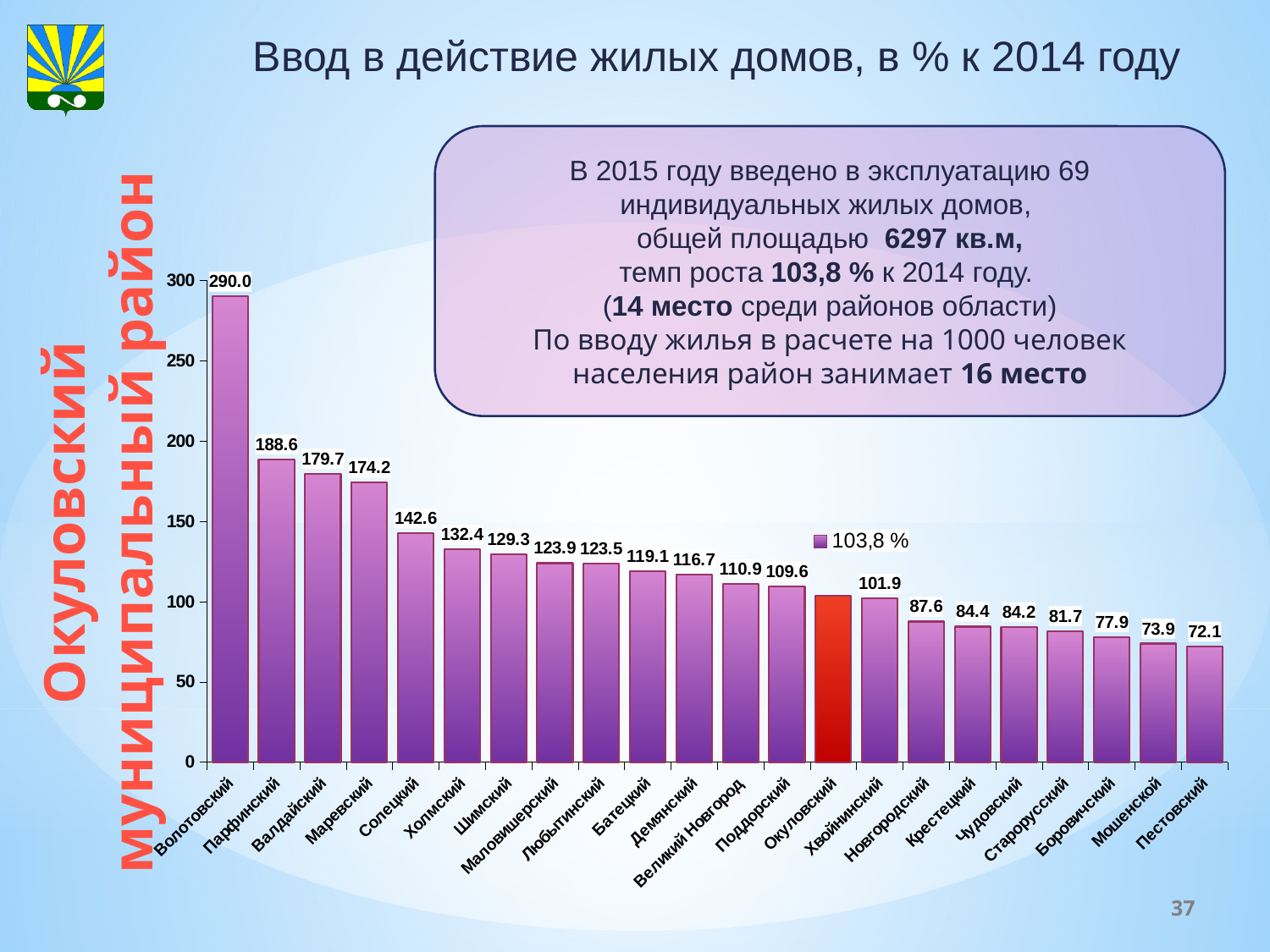
What is the difference between the values for Парфинский and Валдайский? 8.9 How many districts are shown on the chart? 22 Which district has the lowest value on the chart? Пестовский What kind of chart is shown on the slide? bar chart What is the value for Волотовский? 290.0 What is the value for Великий Новгород? 110.9 Which bar is coloured red, unlike the others? Окуловский Which district has the highest value on the chart? Волотовский Which is larger, the value for Солецкий or the value for Холмский? Солецкий What is the value for Пестовский? 72.1 Is the value for Окуловский greater or less than 150? less